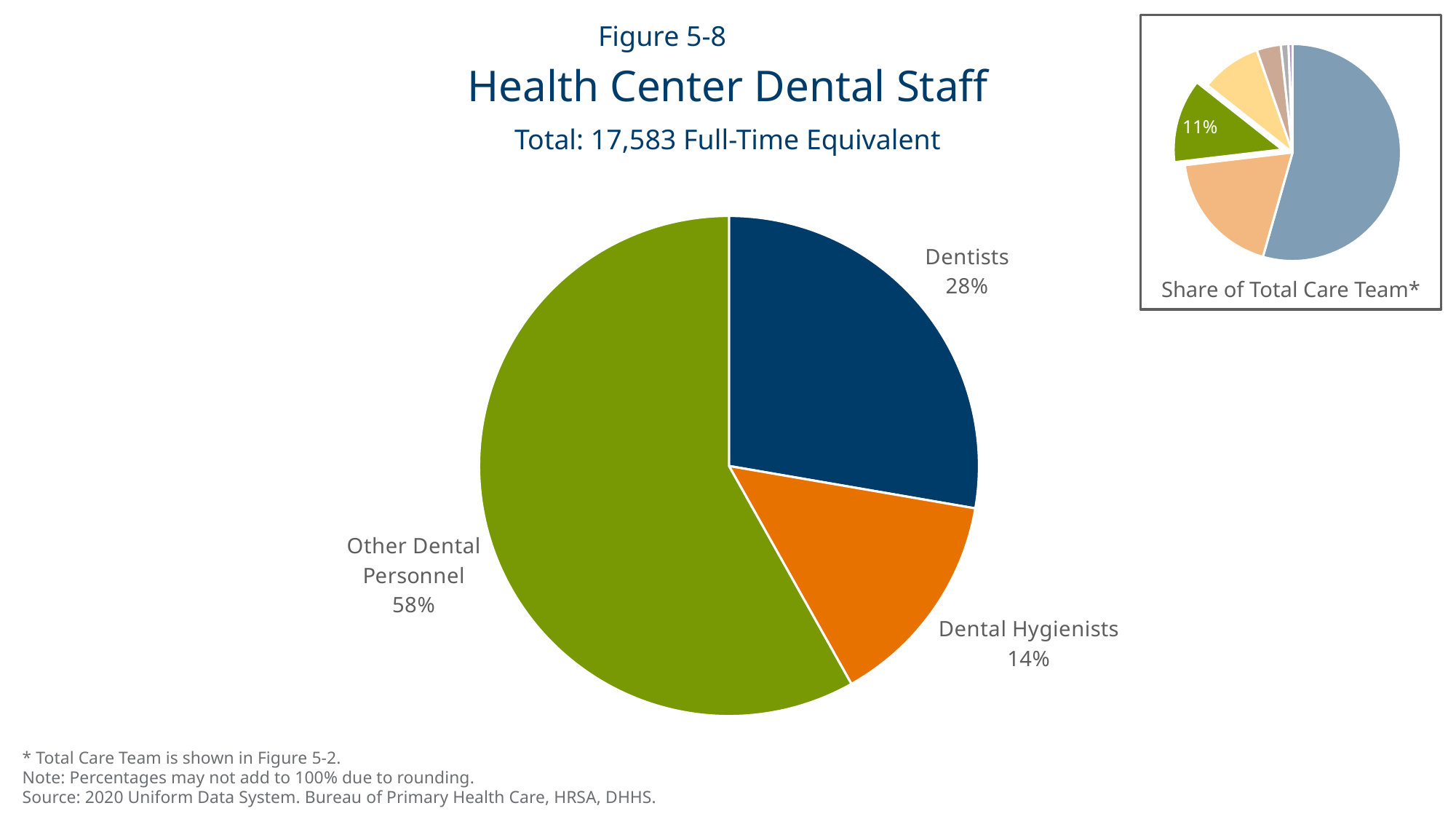
What is the figure number shown above the Health Center Dental Staff chart title? Figure 5-8 In the Health Center Dental Staff pie chart, what share is labeled for Other Dental Personnel? 58% In the Health Center Dental Staff pie chart, what is the difference in percentage points between Dentists and Dental Hygienists? 14 In the Health Center Dental Staff pie chart, which category has the largest share? Other Dental Personnel In the Health Center Dental Staff pie chart, what share is labeled for Dentists? 28% How many categories are shown in the Health Center Dental Staff pie chart? 3 What kind of chart is the Health Center Dental Staff chart? Pie chart In the Health Center Dental Staff pie chart, which is larger: the share for Dentists or the share for Dental Hygienists? Dentists What total Full-Time Equivalent is stated in the subtitle of the Health Center Dental Staff chart? 17,583 In the Health Center Dental Staff pie chart, what share is labeled for Dental Hygienists? 14% In the Health Center Dental Staff pie chart, which category has the smallest share? Dental Hygienists In the small Share of Total Care Team pie chart in the top right, what percentage is labeled on the highlighted green slice? 11%